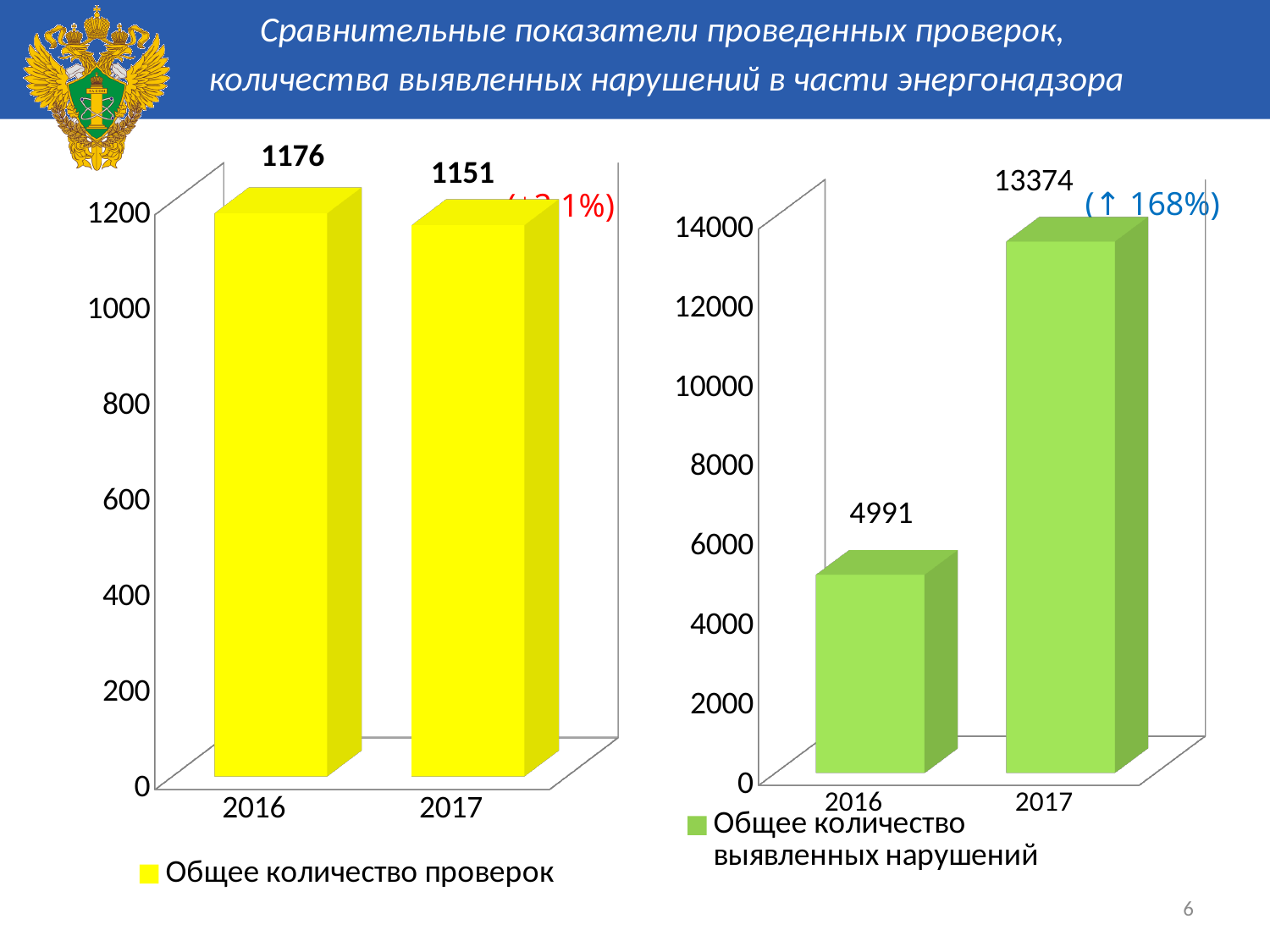
On the left chart, what is the difference between the 2016 and 2017 values? 25 On the right chart, what is the difference between the 2017 and 2016 values? 8383 How many categories (years) are shown on the right chart? 2 On the right chart (Общее количество выявленных нарушений), what is the value for 2017? 13374 On the right chart, do the values rise or fall from 2016 to 2017? rise On the left chart (Общее количество проверок), what is the value for 2016? 1176 What kind of chart is the left chart? bar chart On the right chart, is the value for 2016 greater or less than 6000? less On the left chart, which year has the higher number of проверок? 2016 On the right chart, which year has the lower number of выявленных нарушений? 2016 On the left chart (Общее количество проверок), what is the value for 2017? 1151 On the right chart (Общее количество выявленных нарушений), what is the value for 2016? 4991